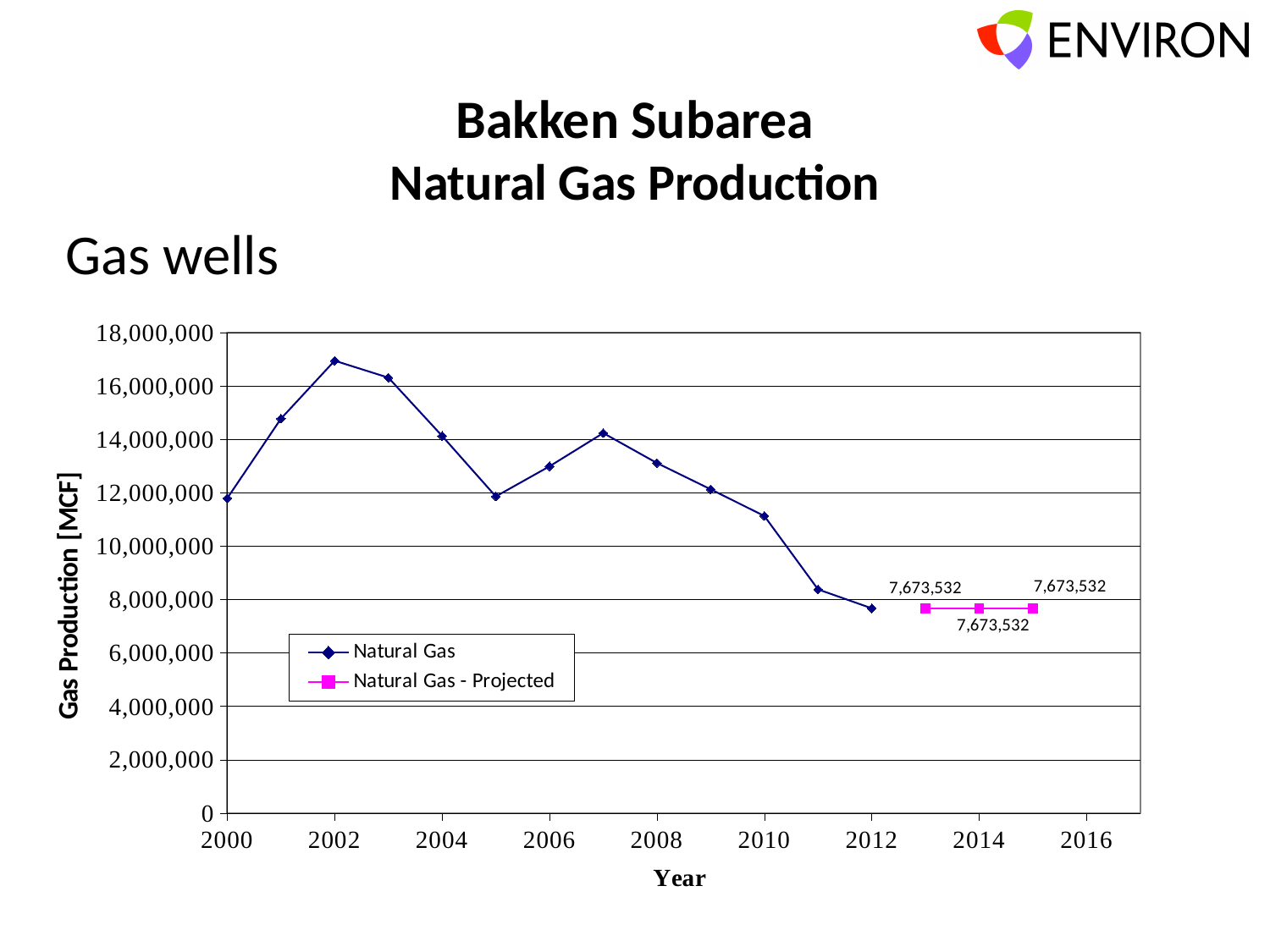
In which year is the Natural Gas series at its highest? 2002 What is the projected natural gas production value for 2015? 7,673,532 Is the Natural Gas value for 2002 greater or less than 16,000,000? greater What is the projected natural gas production value for 2014? 7,673,532 Is the Natural Gas value for 2010 greater or less than 12,000,000? less In which year is the Natural Gas series at its lowest? 2012 Which year has the higher Natural Gas value, 2006 or 2009? 2006 What type of chart is shown on the slide? line chart What is the title of the y axis? Gas Production [MCF] How many data points does the Natural Gas - Projected series have? 3 How many series does the legend list? 2 Does the Natural Gas series rise or fall from 2007 to 2012? fall